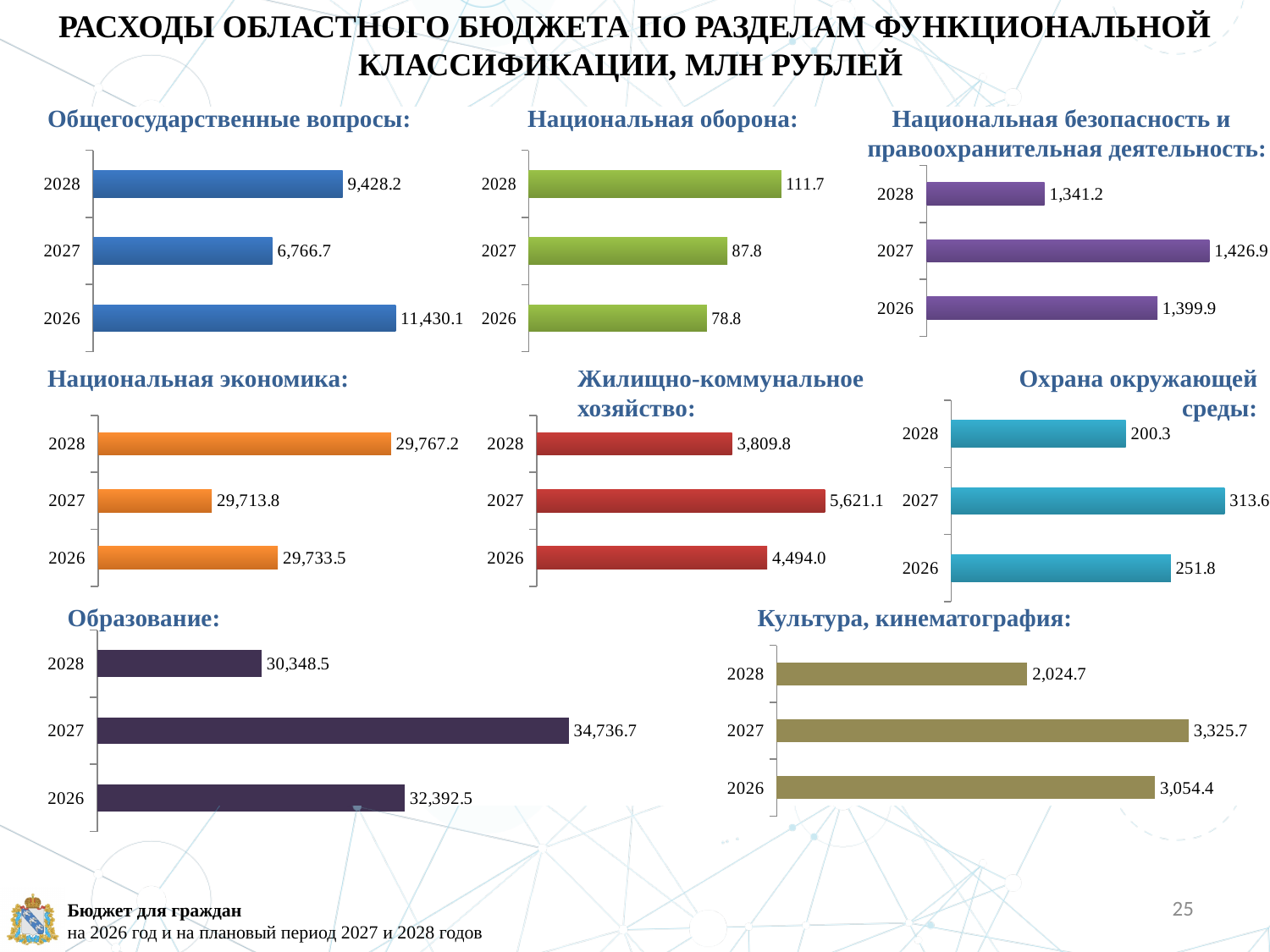
In the 'Образование' chart, what is the value for 2027? 34,736.7 In the 'Национальная оборона' chart, which year has the highest value? 2028 How many bars does the 'Образование' chart have? 3 In the 'Жилищно-коммунальное хозяйство' chart, which year has the lowest value? 2028 In the 'Общегосударственные вопросы' chart, what is the value for 2026? 11,430.1 In the 'Культура, кинематография' chart, what is the difference between the 2027 and 2028 values? 1,301.0 In the 'Национальная оборона' chart, what is the difference between the 2028 and 2026 values? 32.9 What type of chart is used for 'Национальная экономика'? Bar chart In the 'Охрана окружающей среды' chart, which is larger, the value for 2027 or the value for 2026? 2027 In the 'Национальная экономика' chart, what is the value for 2028? 29,767.2 In the 'Жилищно-коммунальное хозяйство' chart, what is the difference between the 2027 and 2026 values? 1,127.1 In the 'Национальная безопасность и правоохранительная деятельность' chart, what is the value for 2027? 1,426.9